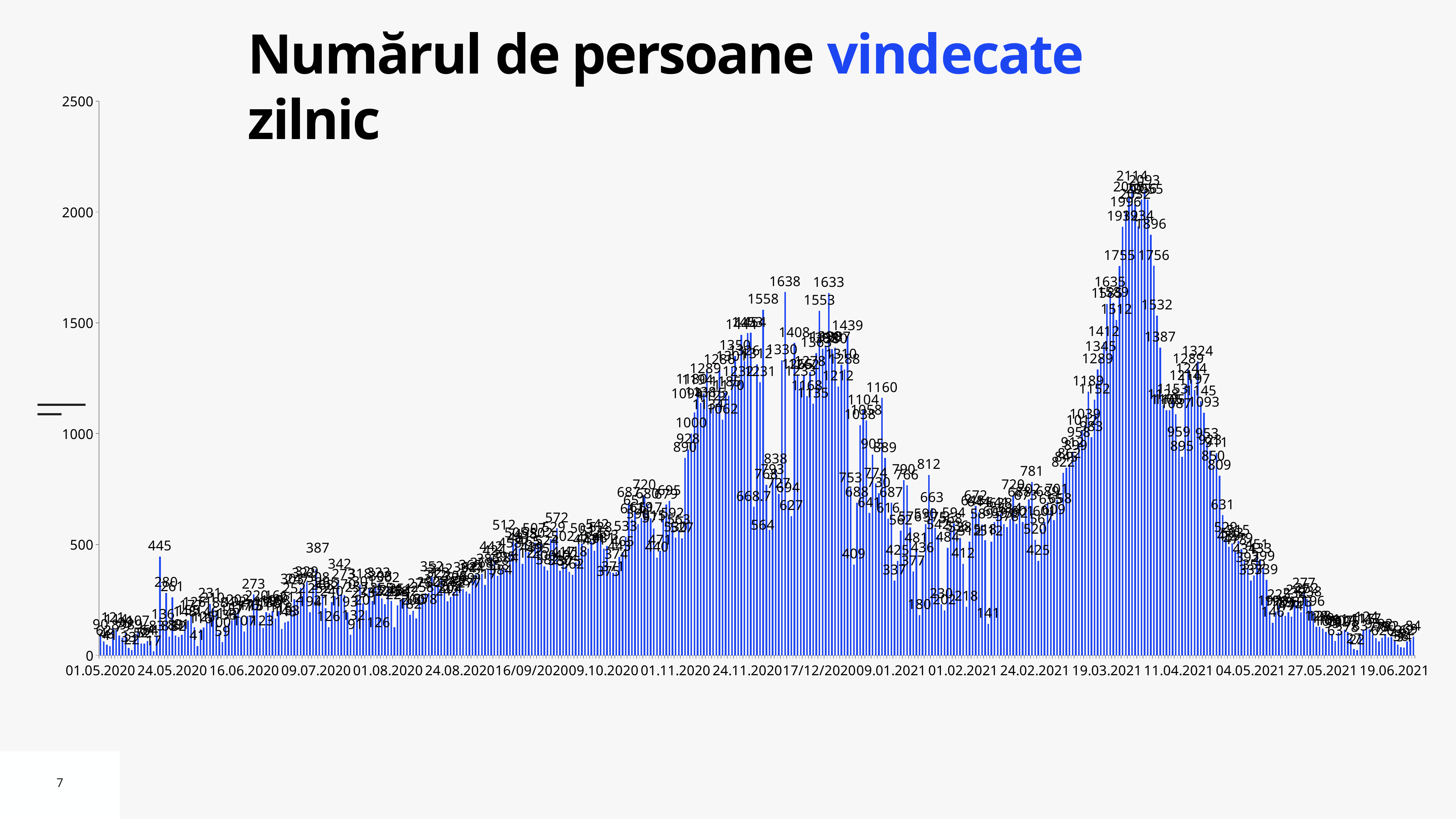
Is the value for 11.04.2021 greater or less than 1500? less Do the values generally rise or fall between 11.04.2021 and 19.06.2021? fall What kind of chart is shown on the slide? bar chart What is the highest daily value labelled on the chart? 2114 What is the title of the chart? Numărul de persoane vindecate zilnic What is the difference between the highest value 2114 and the November 2020 peak of 1638? 476 What is the difference between the spike of 445 and the spike of 387? 58 What is the highest tick value shown on the vertical axis? 2500 Is the value for 01.05.2020 greater or less than 500? less Which is larger, the spike of 445 in May 2020 or the spike of 387 in July 2020? 445